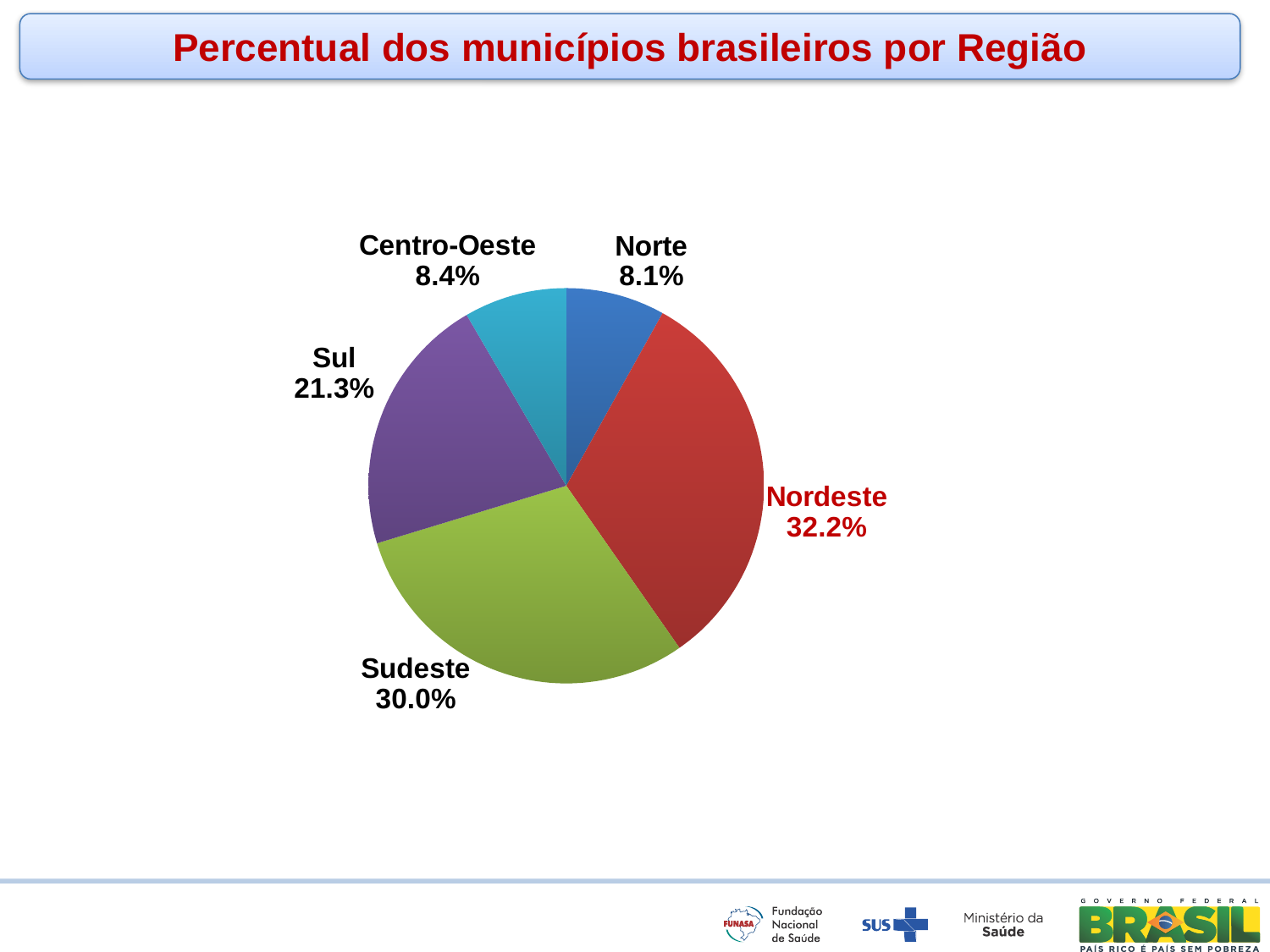
What is the value shown for Centro-Oeste? 8.4% What is the title of the slide? Percentual dos municípios brasileiros por Região Which is larger, the share for Sudeste or the share for Sul? Sudeste What is the value shown for the Sul slice? 21.3% Which slice's label is written in red text? Nordeste What percentage of Brazilian municipalities is in the Nordeste region? 32.2% Which region has the smallest share of municipalities? Norte What type of chart is shown on the slide? pie chart How many regions (slices) are shown in the pie chart? 5 What is the difference between the Nordeste and Sudeste shares? 2.2% Which region has the largest share of municipalities? Nordeste What is the difference between the Sul and Centro-Oeste shares? 12.9%